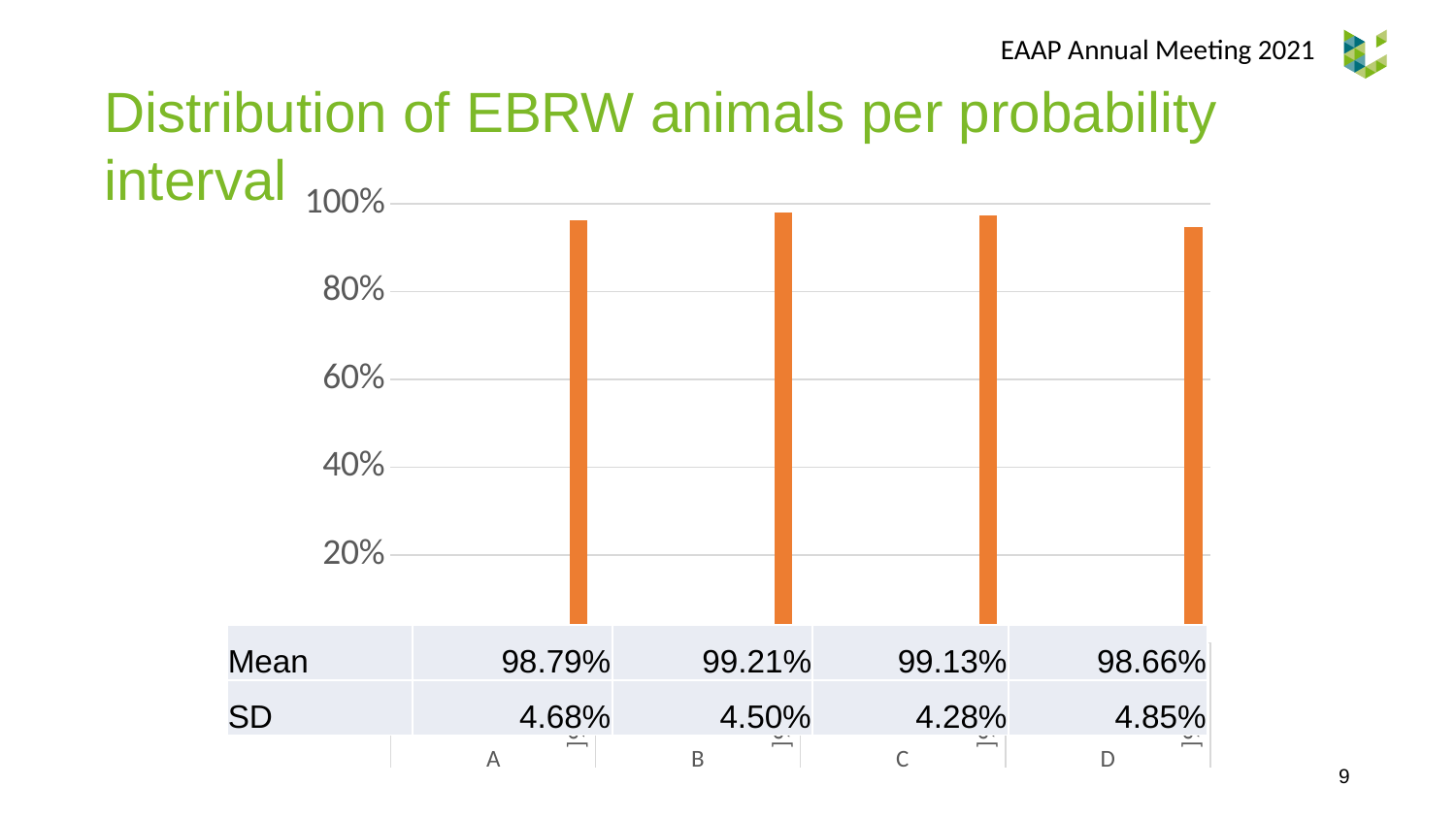
Which bar is taller, B or D? B What is the difference between the Mean values shown for B and A? 0.42% What SD value is shown in the table for category C? 4.28% What Mean value is shown in the table for category A? 98.79% What kind of chart is shown on the slide? bar chart Is the value for category A greater or less than 80%? greater What colour are the bars in the chart? orange Which category has the highest Mean value in the table? B What is the title of the chart on the slide? Distribution of EBRW animals per probability interval How many categories are shown on the x axis of the chart? 4 Is the value for category D greater or less than 60%? greater Which category has the lowest SD value in the table? C